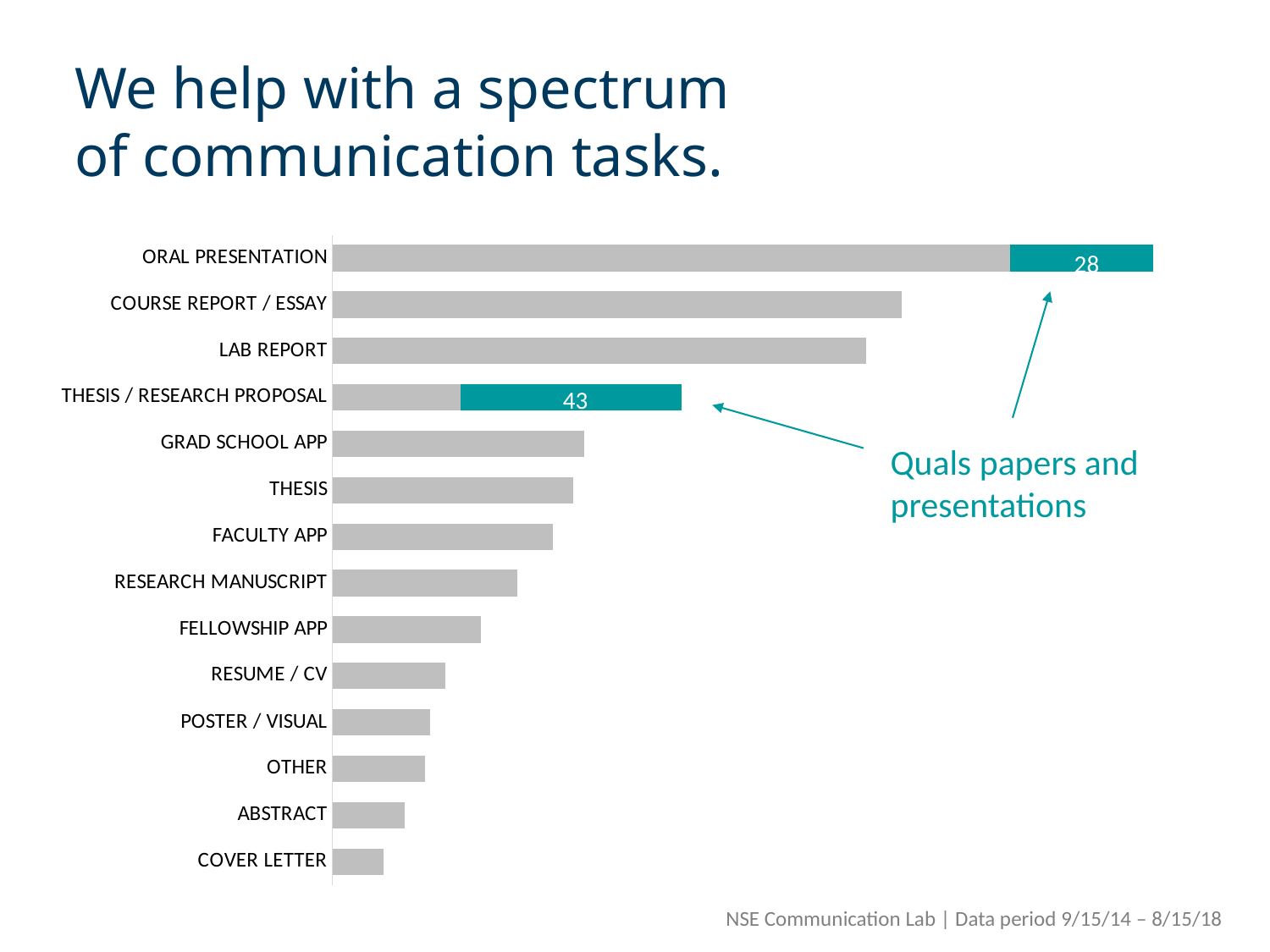
Which category has the longest bar? Oral Presentation Which bar is longer, Fellowship App or Resume / CV? Fellowship App What value is printed on the highlighted segment of the Thesis / Research Proposal bar? 43 How many categories are plotted in the chart? 14 Which category has the shortest bar? Cover Letter What is the title of the slide containing the chart? We help with a spectrum of communication tasks. What kind of chart is shown on the slide? bar chart Do the bar lengths increase or decrease going from the top category to the bottom category? decrease What do the highlighted (teal) segments of the bars represent, according to the annotation? Quals papers and presentations What is the difference between the highlighted values for Thesis / Research Proposal (43) and Oral Presentation (28)? 15 What value is printed on the highlighted segment of the Oral Presentation bar? 28 Which bar is longer, Course Report / Essay or Lab Report? Course Report / Essay